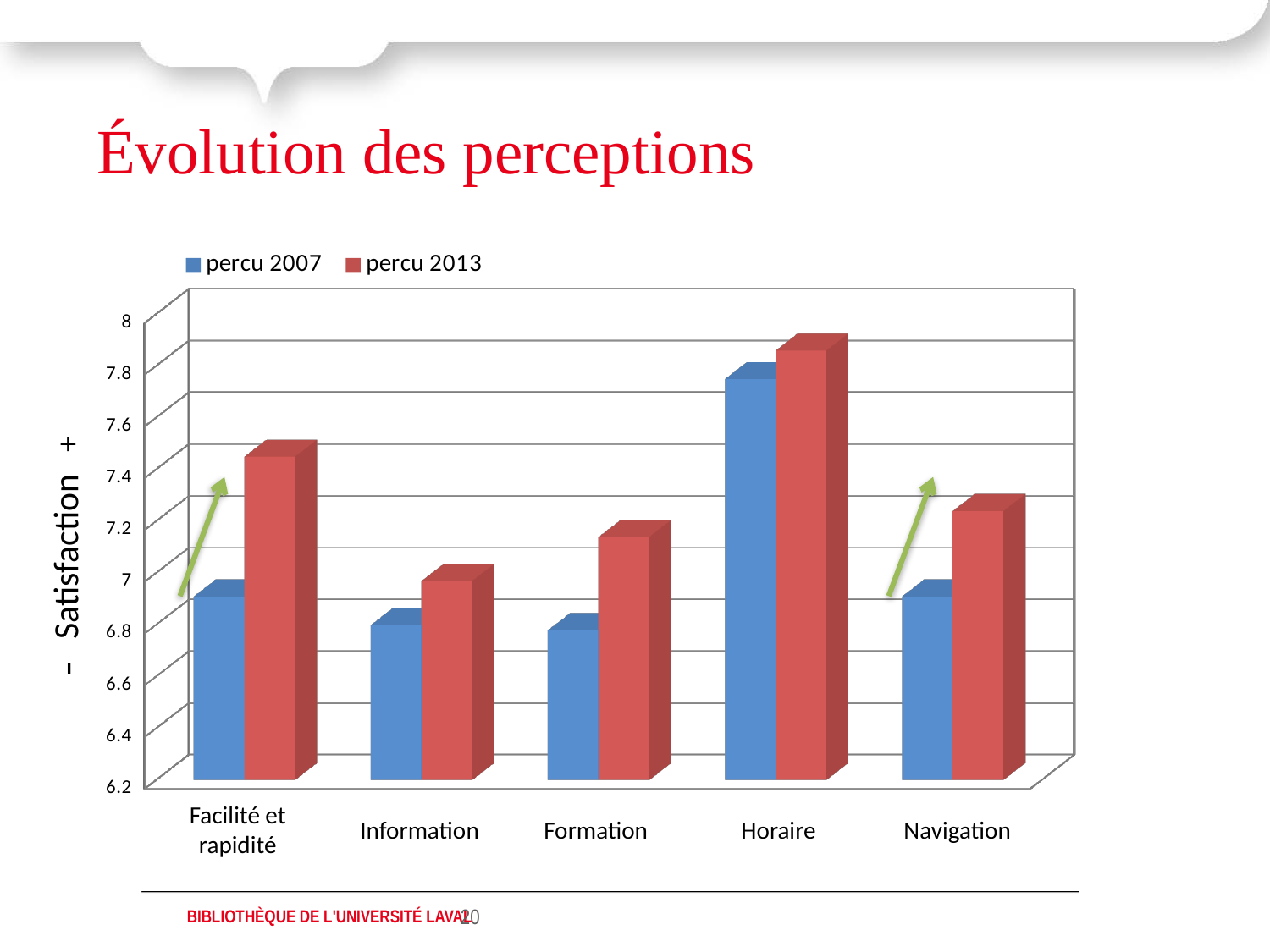
What are the two series named in the legend? percu 2007 and percu 2013 Is the percu 2013 value for Facilité et rapidité greater or less than 7.2? greater Which is larger for percu 2013: Facilité et rapidité or Navigation? Facilité et rapidité Is the percu 2007 value for Horaire greater or less than 7.6? greater How many categories are shown on the x axis? 5 Which category has the highest value for percu 2007? Horaire For Facilité et rapidité, which is larger: the percu 2007 value or the percu 2013 value? percu 2013 Which category has the highest value for percu 2013? Horaire Which category has the lowest value for percu 2013? Information How many series does the legend list? 2 What kind of chart is shown on the slide? Bar chart Is the percu 2007 value for Information greater or less than 7? less